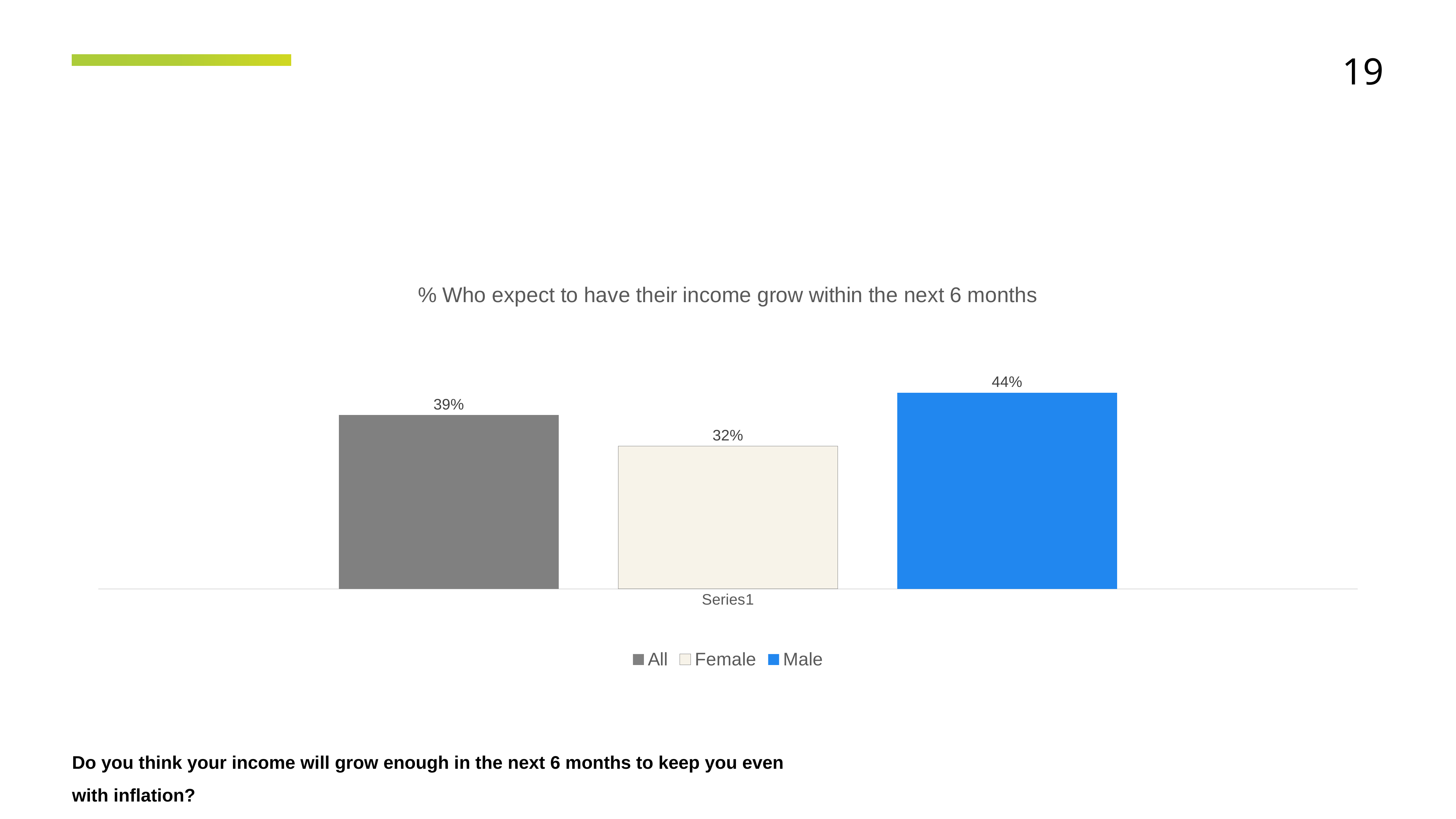
How many series does the legend list? 3 What colour is the Male bar? Blue Which group has the lowest value? Female Which is larger, the value for All or the value for Female? All What kind of chart is shown? Bar chart What is the difference between the Male and Female values? 12% Which group has the highest value? Male What is the title of the chart? % Who expect to have their income grow within the next 6 months What is the value for Female? 32% What is the value for Male? 44% What is the value for All? 39% What is the difference between the Male and All values? 5%